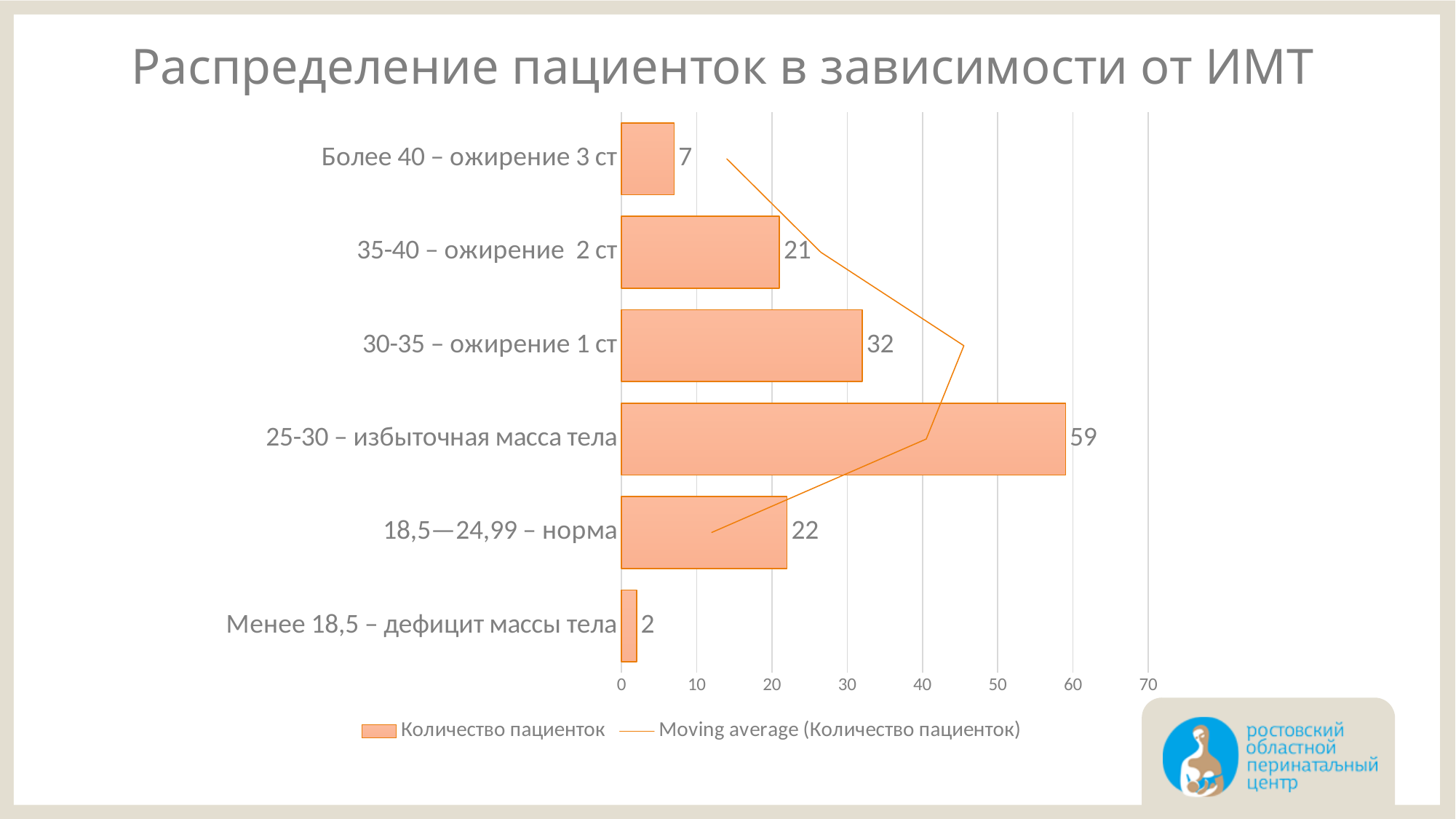
Which category has the highest number of patients? 25-30 – избыточная масса тела What is the value for the category "Менее 18,5 – дефицит массы тела"? 2 Is the value for "30-35 – ожирение 1 ст" greater or less than 40? less Which category has the lowest number of patients? Менее 18,5 – дефицит массы тела What is the value for the category "30-35 – ожирение 1 ст"? 32 Which is larger: the value for "35-40 – ожирение 2 ст" or the value for "Более 40 – ожирение 3 ст"? 35-40 – ожирение 2 ст How many entries does the legend list? 2 How many categories are shown in the chart? 6 What is the value for the category "25-30 – избыточная масса тела"? 59 What is the value for the category "18,5—24,99 – норма"? 22 What is the difference between the values for "25-30 – избыточная масса тела" and "30-35 – ожирение 1 ст"? 27 What type of chart is shown on the slide? Bar chart